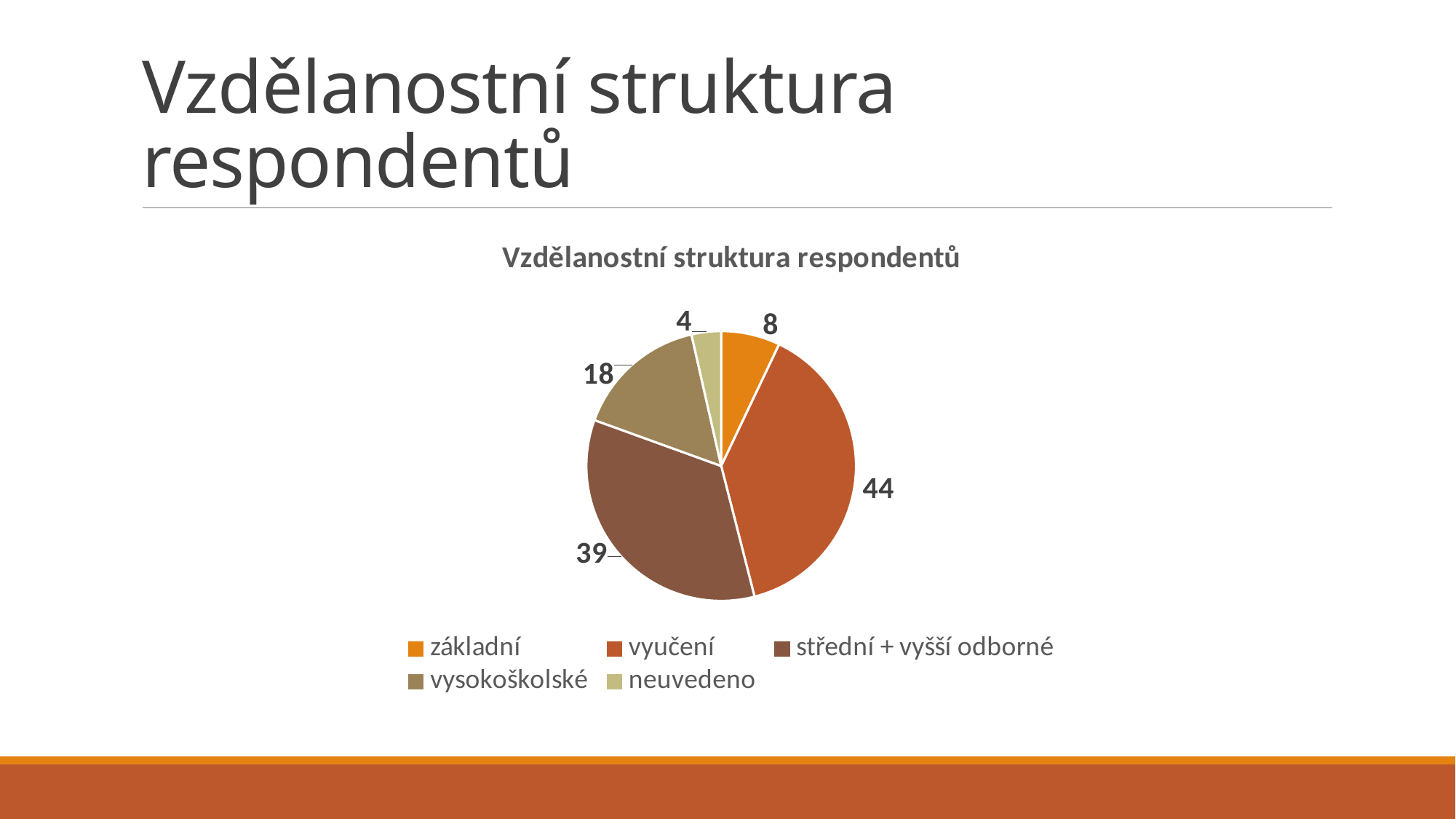
Which category has the smallest slice? neuvedeno What is the value for základní? 8 What is the value for střední + vyšší odborné? 39 What is the difference between the values for vyučení and střední + vyšší odborné? 5 What is the value for neuvedeno? 4 How many categories does the pie chart have? 5 What is the title of the chart? Vzdělanostní struktura respondentů What is the value for vysokoškolské? 18 Which category has the largest slice? vyučení What is the value for vyučení? 44 Which is larger, the value for vysokoškolské or the value for základní? vysokoškolské What type of chart is shown on the slide? pie chart